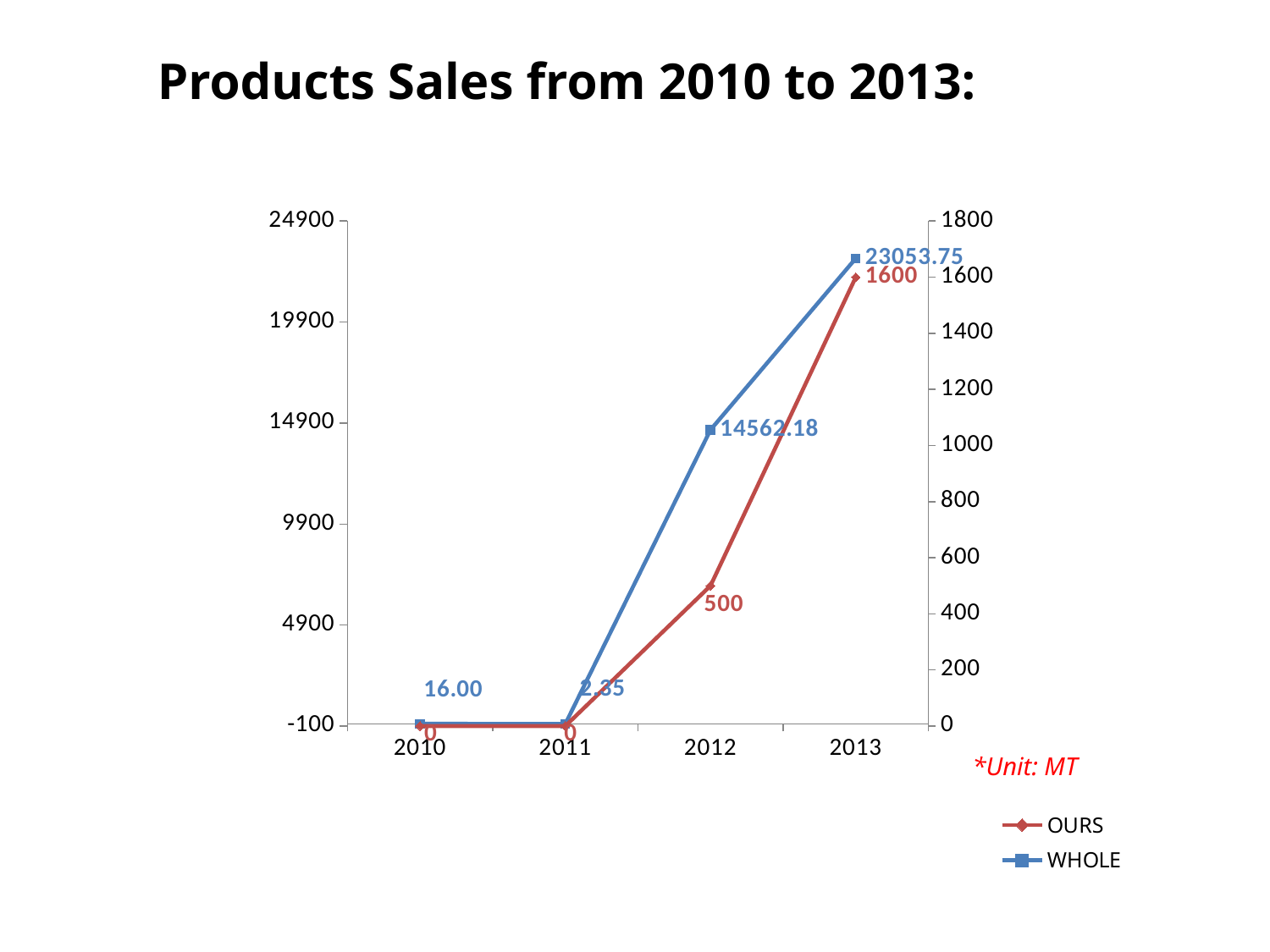
In which year is the WHOLE series lowest? 2011 What is the value for WHOLE in 2013? 23053.75 What is the difference between the OURS values for 2013 and 2012? 1100 In which year is the WHOLE series highest? 2013 How many years are shown on the x axis? 4 What is the value for WHOLE in 2012? 14562.18 What kind of chart is shown on the slide? Line chart For the WHOLE series, which year has the larger value, 2010 or 2011? 2010 How many series does the legend list? 2 What is the value for WHOLE in 2010? 16.00 What is the value for OURS in 2013? 1600 What is the value for OURS in 2012? 500